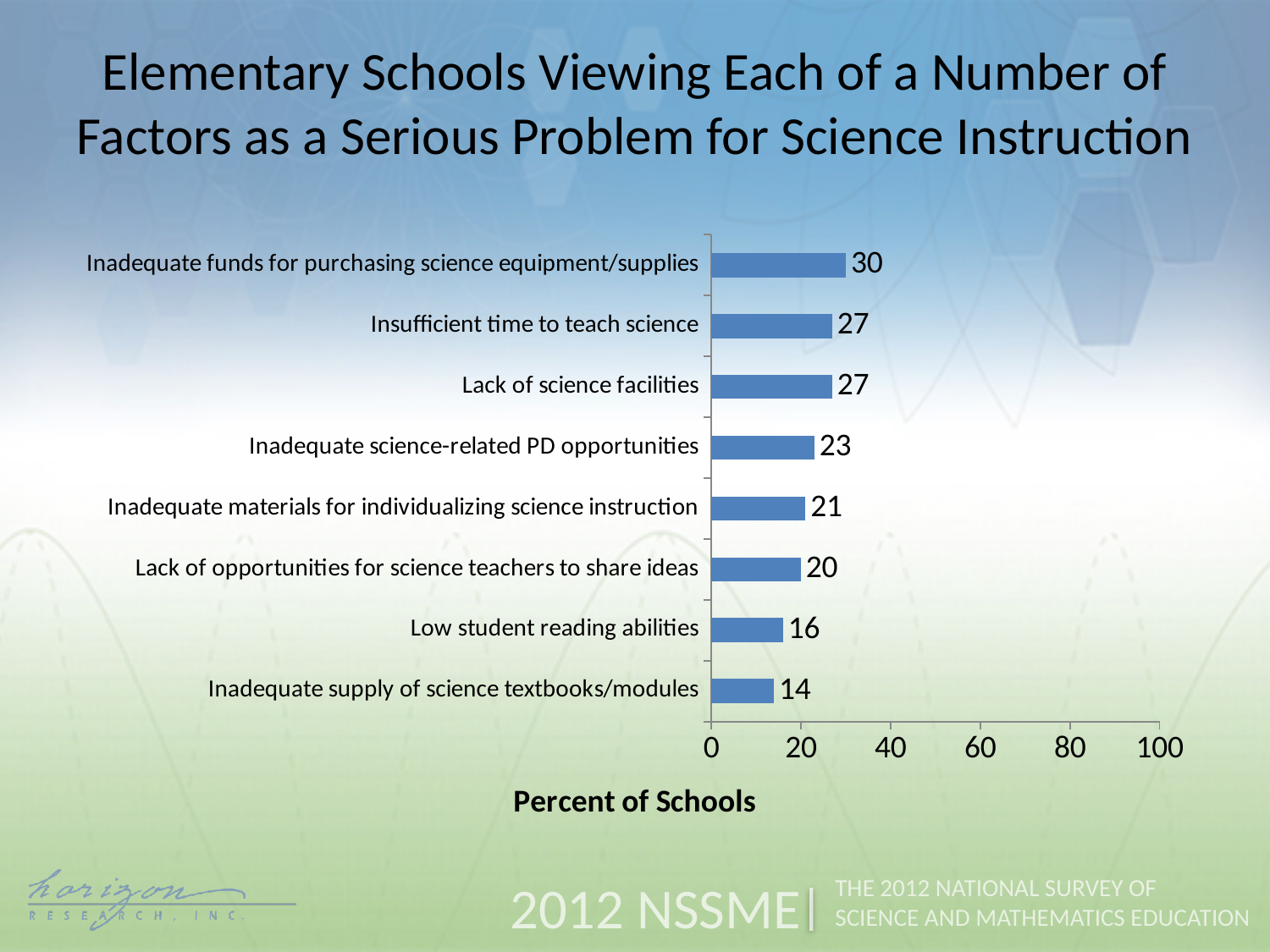
Which factor has the highest percent of schools viewing it as a serious problem? Inadequate funds for purchasing science equipment/supplies How many factors are shown in the chart? 8 What is the value for 'Low student reading abilities'? 16 Is the value for 'Inadequate materials for individualizing science instruction' greater or less than 40? less Which factor has the lowest percent of schools viewing it as a serious problem? Inadequate supply of science textbooks/modules What percent of schools view inadequate funds for purchasing science equipment/supplies as a serious problem? 30 What is the value for 'Inadequate science-related PD opportunities'? 23 What is the label of the horizontal axis? Percent of Schools What is the maximum value shown on the horizontal axis? 100 What kind of chart is shown on the slide? bar chart What is the difference between the values for 'Inadequate funds for purchasing science equipment/supplies' and 'Inadequate supply of science textbooks/modules'? 16 Which is larger: the value for 'Lack of science facilities' or the value for 'Low student reading abilities'? Lack of science facilities